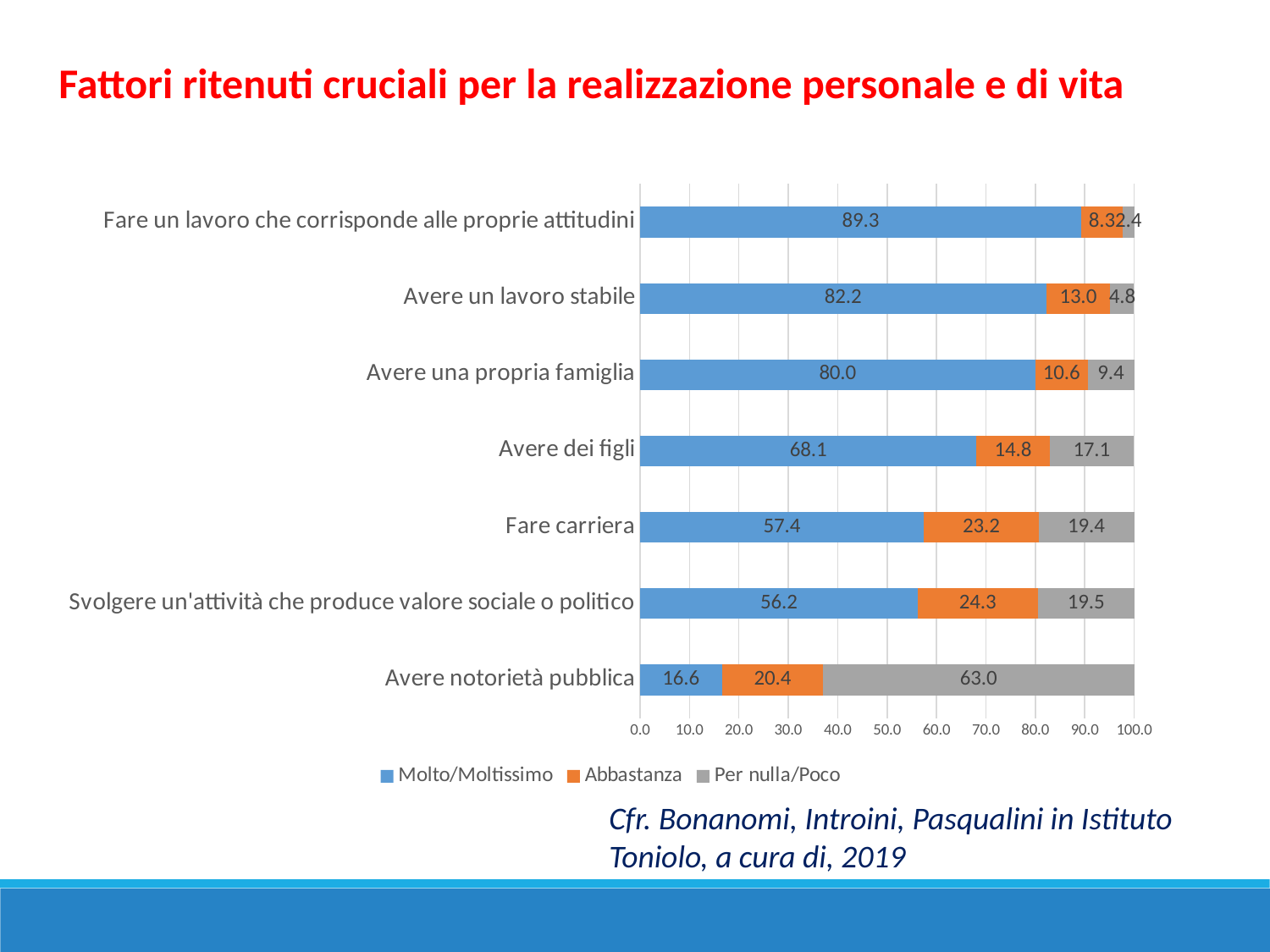
What is the Molto/Moltissimo value for "Avere un lavoro stabile"? 82.2 Which category has the lowest Molto/Moltissimo value? Avere notorietà pubblica Which series is shown in orange in the legend? Abbastanza How many categories are plotted on the chart? 7 Is the Molto/Moltissimo value for "Svolgere un'attività che produce valore sociale o politico" greater or less than 50.0? greater Which category has the highest Molto/Moltissimo value? Fare un lavoro che corrisponde alle proprie attitudini What is the Abbastanza value for "Fare carriera"? 23.2 What is the Per nulla/Poco value for "Avere notorietà pubblica"? 63.0 How many series does the legend list? 3 Which has a larger Per nulla/Poco value, "Avere dei figli" or "Avere una propria famiglia"? Avere dei figli What is the difference between the Molto/Moltissimo values for "Avere una propria famiglia" and "Avere dei figli"? 11.9 What kind of chart is shown on the slide? Stacked bar chart